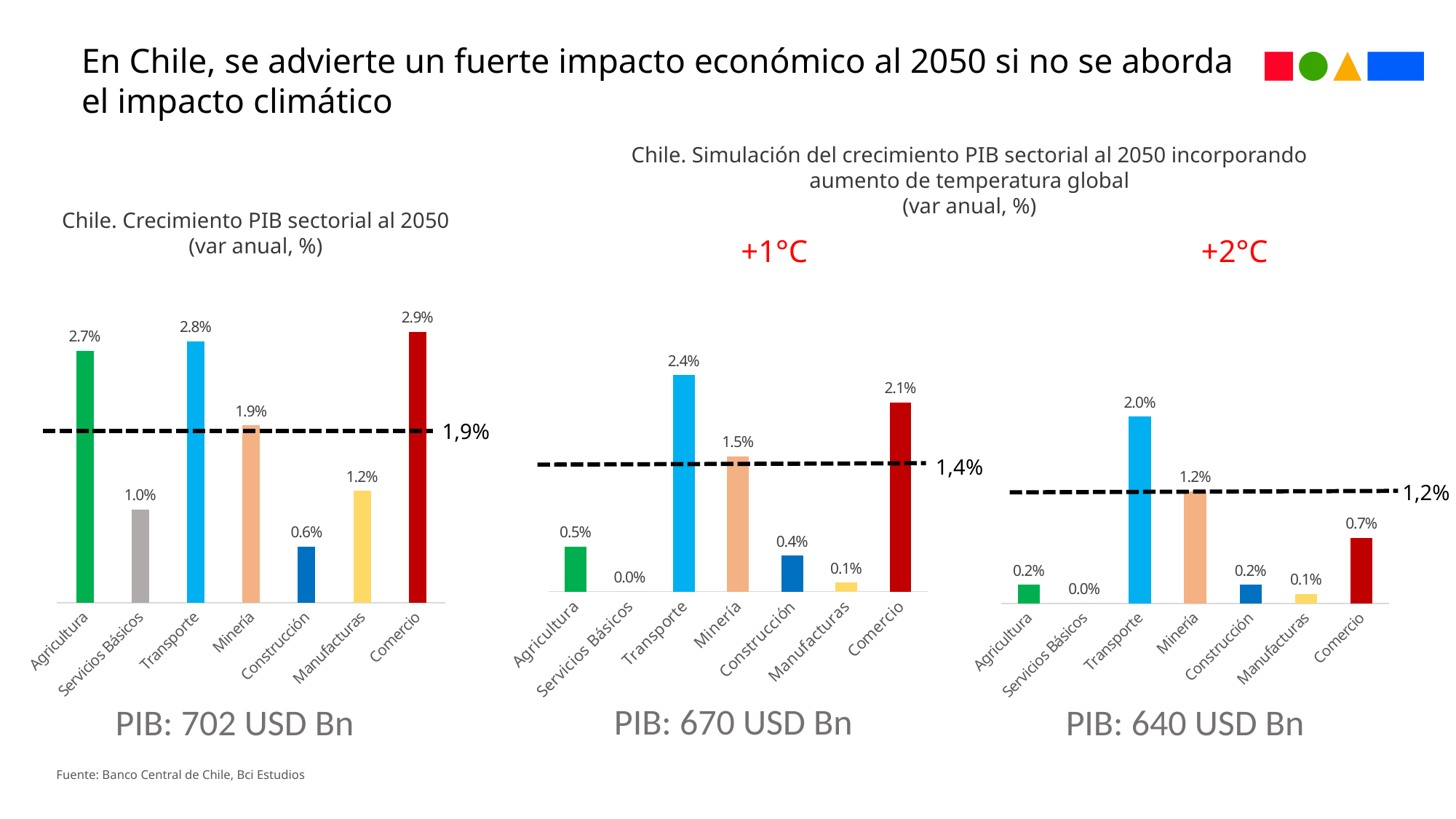
In the middle chart (+1°C), what is the value for Minería? 1.5% In the left chart (Chile. Crecimiento PIB sectorial al 2050), which category has the lowest value? Construcción What value does the dashed line in the middle chart (+1°C) mark? 1,4% In the right chart (+2°C), what is the difference between Transporte and Minería? 0.8% In the left chart (Chile. Crecimiento PIB sectorial al 2050), what is the difference between Agricultura and Minería? 0.8% How many categories are shown in the right chart (+2°C)? 7 In the middle chart (+1°C), which category has the highest value? Transporte In the left chart (Chile. Crecimiento PIB sectorial al 2050), which category has the highest value? Comercio In the left chart (Chile. Crecimiento PIB sectorial al 2050), what is the value for Transporte? 2.8% In the middle chart (+1°C), which is larger, Agricultura or Construcción? Agricultura In the right chart (+2°C), what is the value for Comercio? 0.7% What kind of chart is the left chart (Chile. Crecimiento PIB sectorial al 2050)? Bar chart